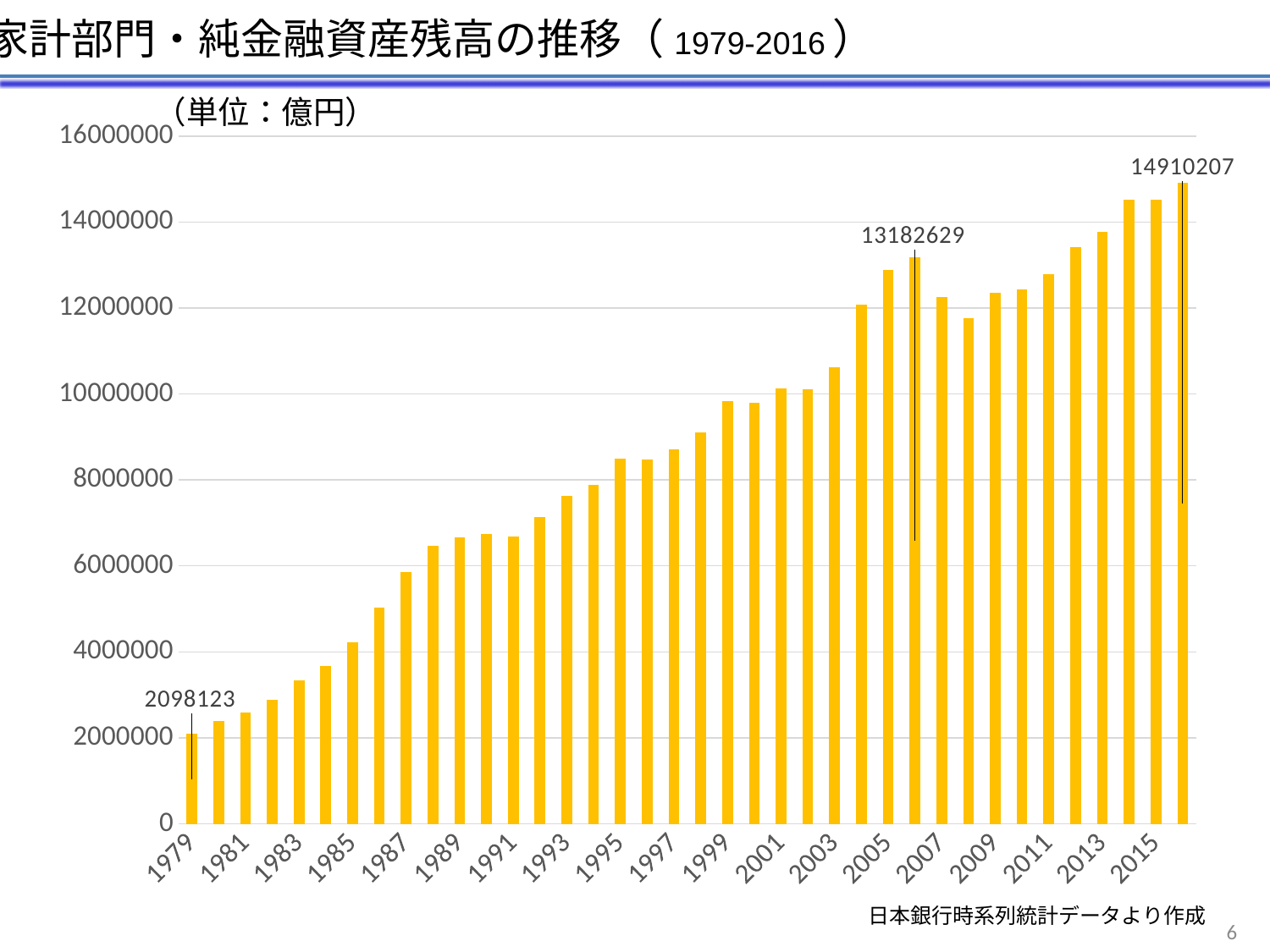
What is the value for 2006? 13182629 What is the value for 1979? 2098123 Which year has the lowest value? 1979 What is the value for 2016? 14910207 Which year has the highest value? 2016 What kind of chart is shown on the slide? Bar chart Is the value for 2009 greater or less than 12000000? greater What is the difference between the values for 2016 and 1979? 12812084 What is the difference between the values for 2016 and 2006? 1727578 Which is larger, the value for 2008 or the value for 2009? 2009 Is the value for 2003 greater or less than 10000000? greater How many years (bars) are plotted in the chart? 38